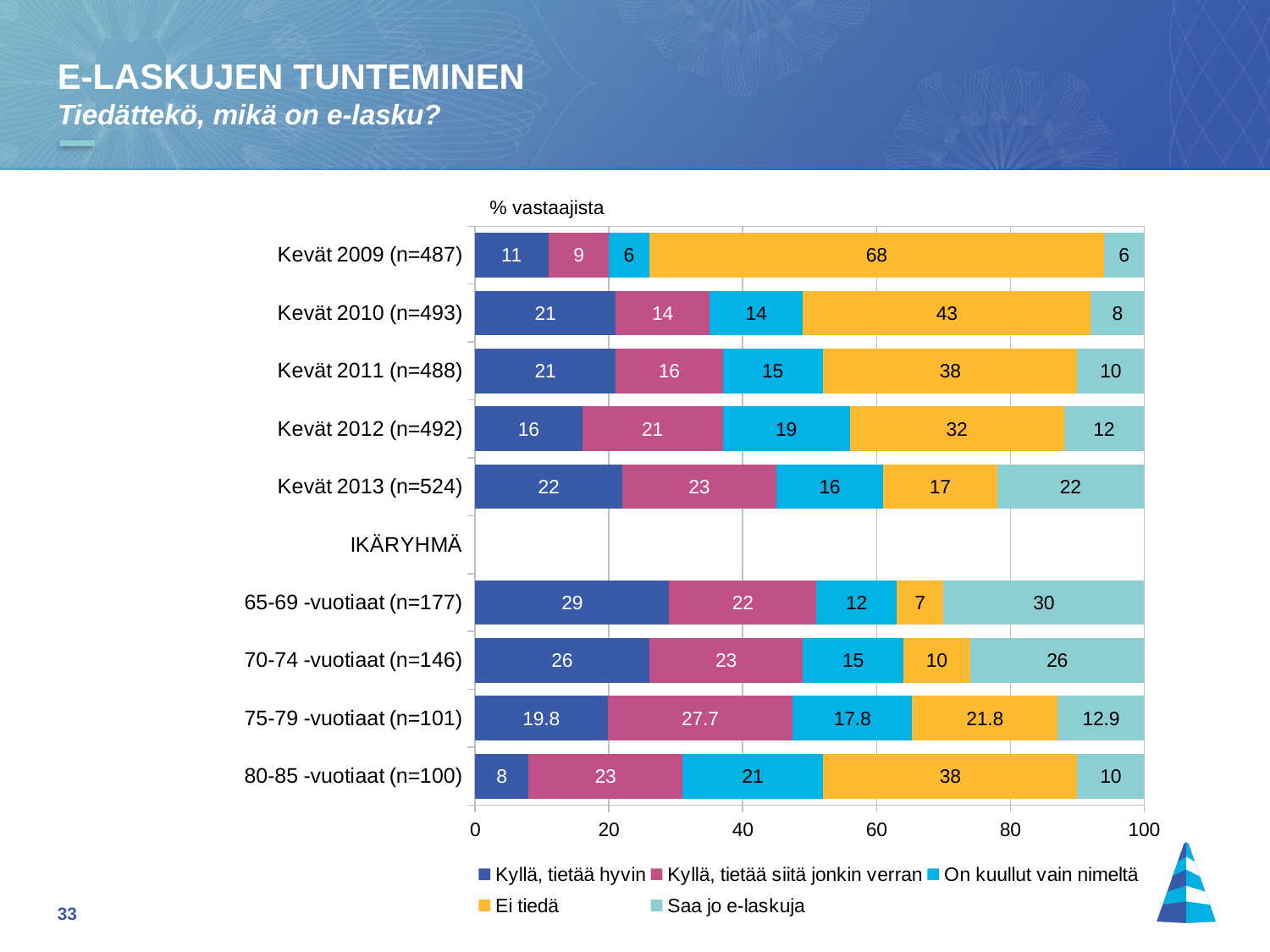
What is the value of "Kyllä, tietää hyvin" for 65-69 -vuotiaat (n=177)? 29 Which category has the lowest value for "Kyllä, tietää hyvin"? 80-85 -vuotiaat (n=100) What is the value of "Ei tiedä" for Kevät 2009 (n=487)? 68 What is the value of "Saa jo e-laskuja" for Kevät 2013 (n=524)? 22 What is the value of "Kyllä, tietää siitä jonkin verran" for 75-79 -vuotiaat (n=101)? 27.7 Which category has the highest value for "Ei tiedä"? Kevät 2009 (n=487) Which is larger: the "Saa jo e-laskuja" value for 65-69 -vuotiaat (n=177) or for 80-85 -vuotiaat (n=100)? 65-69 -vuotiaat (n=177) How many series does the legend list? 5 What is the label shown above the chart's plot area? % vastaajista What type of chart is shown on the slide? Stacked bar chart How does the "Ei tiedä" value change from Kevät 2009 to Kevät 2013? It falls What is the difference between the "Ei tiedä" values for Kevät 2009 (n=487) and Kevät 2013 (n=524)? 51